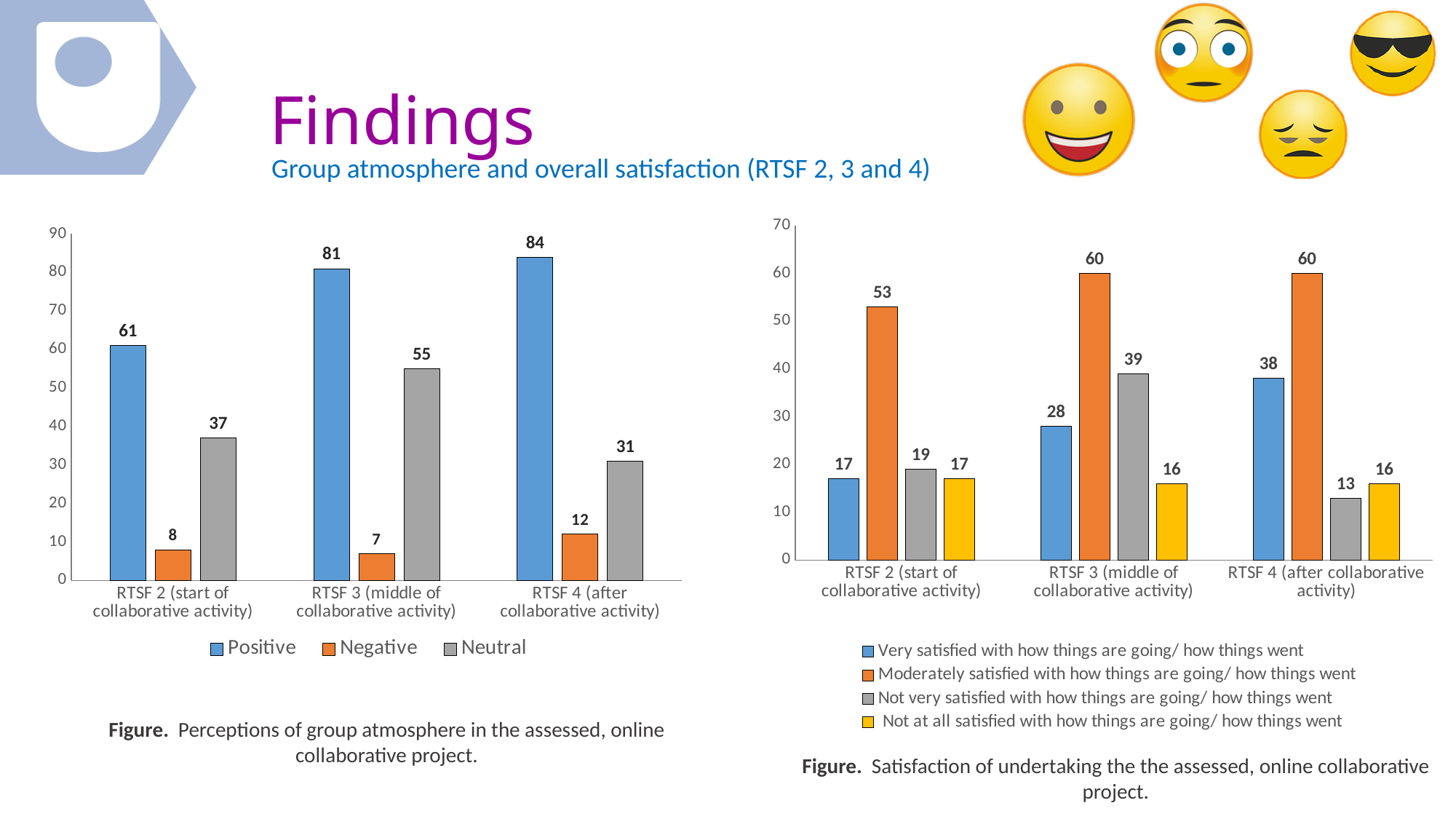
In the right chart (satisfaction), what is the 'Moderately satisfied' value for RTSF 2 (start of collaborative activity)? 53 In the right chart (satisfaction), how many series does the legend list? 4 In the left chart (group atmosphere), does the Positive value rise or fall from RTSF 2 to RTSF 4? rise In the right chart (satisfaction), which is larger for RTSF 3 (middle of collaborative activity): 'Very satisfied' or 'Not very satisfied'? Not very satisfied In the left chart (group atmosphere), which category has the highest Positive value? RTSF 4 (after collaborative activity) In the left chart (group atmosphere), how many series does the legend list? 3 In the right chart (satisfaction), what is the 'Not very satisfied' value for RTSF 4 (after collaborative activity)? 13 In the left chart (group atmosphere), what is the difference between the Positive and Neutral values for RTSF 4 (after collaborative activity)? 53 In the left chart (group atmosphere), what is the Positive value for RTSF 3 (middle of collaborative activity)? 81 In the left chart (group atmosphere), what is the Neutral value for RTSF 2 (start of collaborative activity)? 37 In the left chart (group atmosphere), which category has the lowest Negative value? RTSF 3 (middle of collaborative activity) What type of chart is the right chart (satisfaction)? bar chart